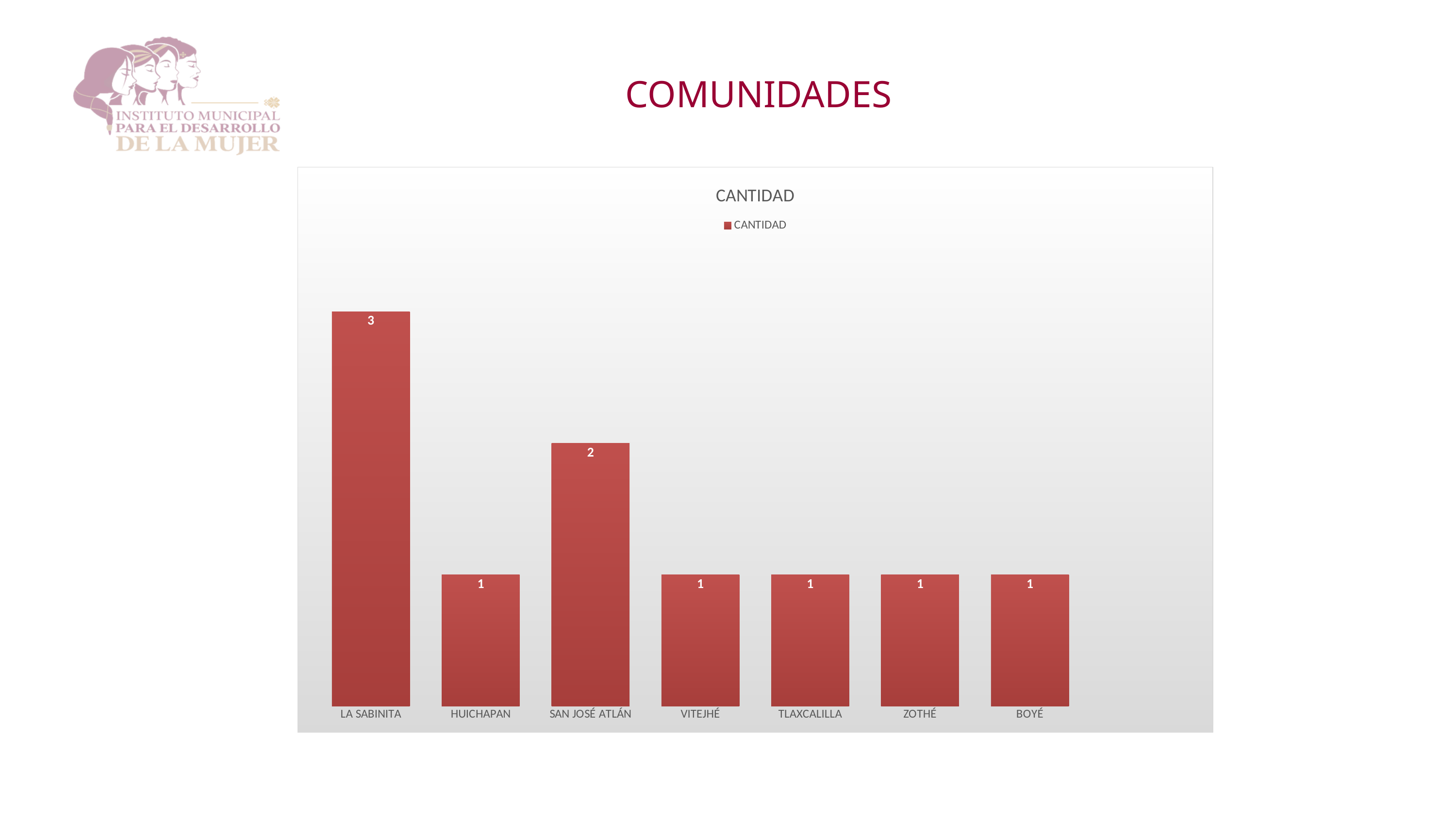
What is the difference between the values for LA SABINITA and SAN JOSÉ ATLÁN? 1 How many series does the legend list? 1 Which category has the highest value? LA SABINITA What is the difference between the values for SAN JOSÉ ATLÁN and VITEJHÉ? 1 What is the value for BOYÉ? 1 What is the value for HUICHAPAN? 1 What is the value for LA SABINITA? 3 What is the title of the chart? CANTIDAD How many categories are shown on the x axis? 7 What kind of chart is shown? bar chart What is the value for SAN JOSÉ ATLÁN? 2 Which is larger, the value for LA SABINITA or the value for HUICHAPAN? LA SABINITA